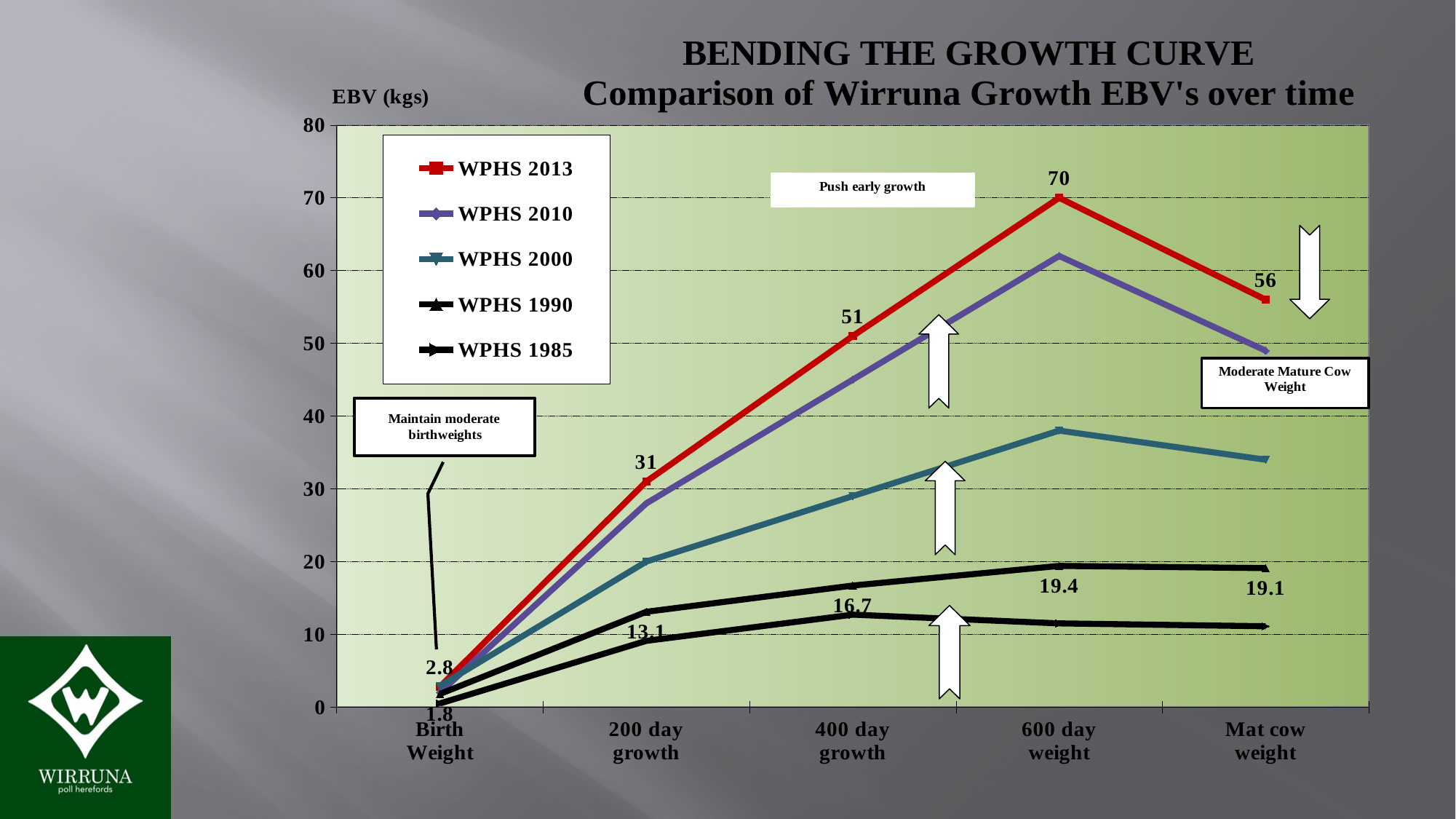
At which category does the WPHS 2013 series reach its highest value? 600 day weight How many categories are shown along the x axis? 5 At 600 day weight, which series has the larger value, WPHS 2013 or WPHS 2010? WPHS 2013 How many series does the legend list? 5 What is the label on the y axis? EBV (kgs) Is the WPHS 2010 value for 400 day growth greater or less than 40? greater What is the WPHS 2013 value for 600 day weight? 70 What is the WPHS 2013 value for Birth Weight? 2.8 What is the WPHS 2013 value for Mat cow weight? 56 What kind of chart is shown on the slide? line chart What is the difference between the WPHS 2013 values for 600 day weight and Mat cow weight? 14 What is the WPHS 2013 value for 200 day growth? 31